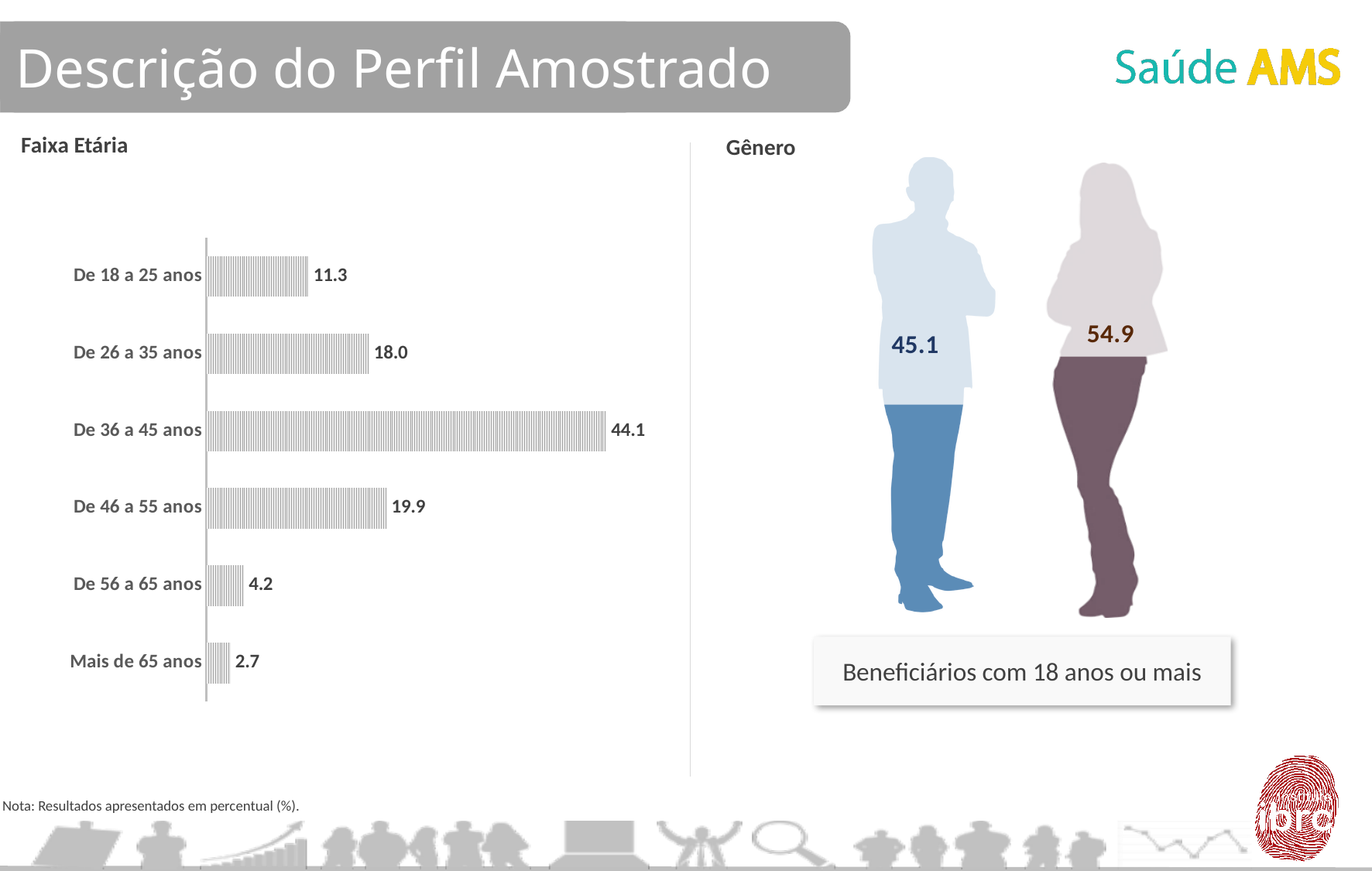
How many age groups are shown in the Faixa Etária chart? 6 In the Faixa Etária chart, which age group has the highest value? De 36 a 45 anos In the Gênero graphic, what is the difference between the female and male values? 9.8 In the Faixa Etária chart, which is larger: De 18 a 25 anos or De 56 a 65 anos? De 18 a 25 anos In the Gênero graphic, what is the value shown for the female figure? 54.9 What kind of chart is the Faixa Etária chart? Bar chart In the Faixa Etária chart, what is the value for De 18 a 25 anos? 11.3 In the Faixa Etária chart, what is the difference between De 46 a 55 anos and De 26 a 35 anos? 1.9 In the Faixa Etária chart, what is the value for De 36 a 45 anos? 44.1 In the Gênero graphic, what is the value shown for the male figure? 45.1 In the Faixa Etária chart, which age group has the lowest value? Mais de 65 anos In the Faixa Etária chart, what is the value for Mais de 65 anos? 2.7